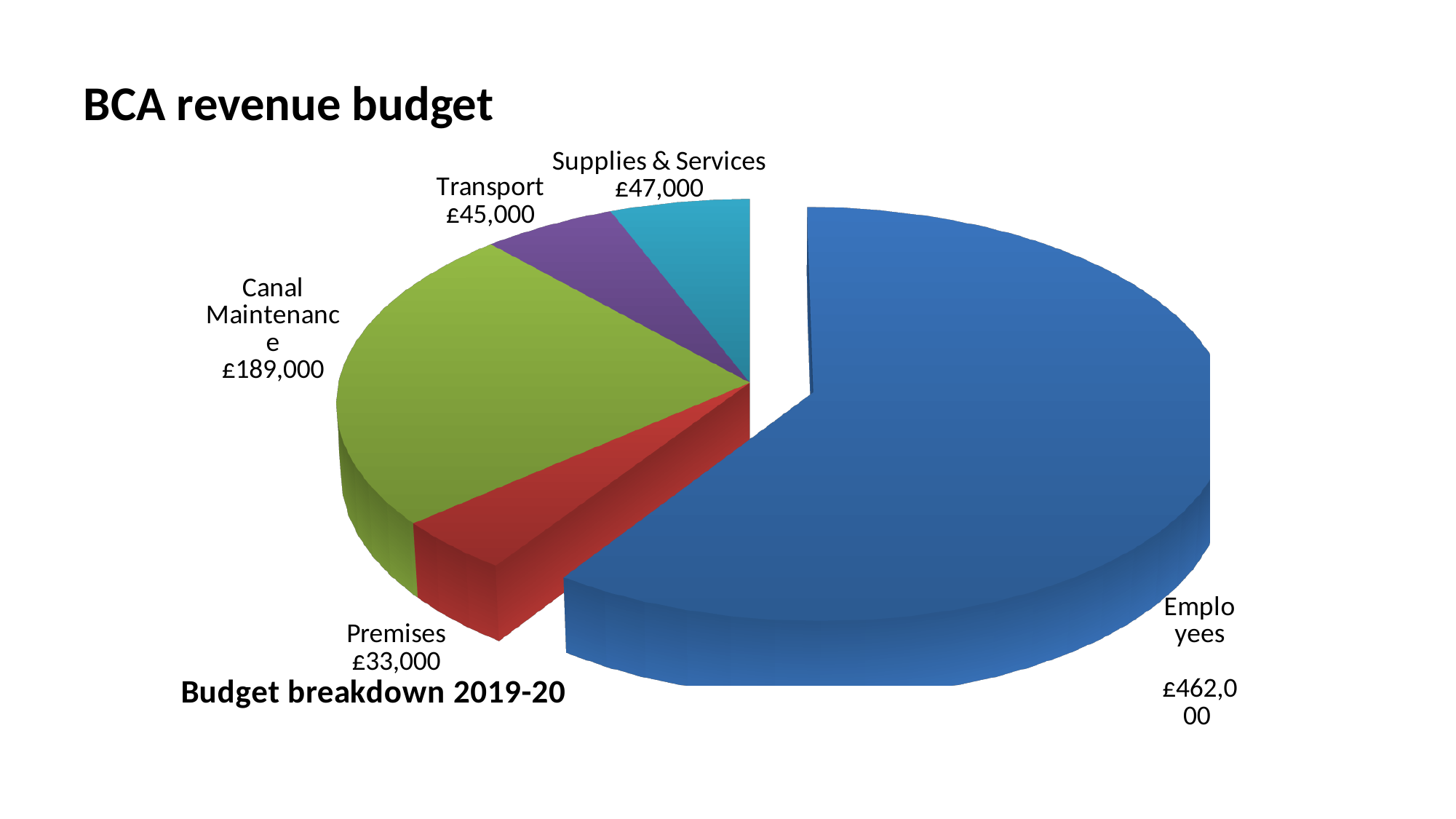
What is the budget value for Premises? £33,000 Which category has the largest budget? Employees What kind of chart is shown on the slide? Pie chart Which is larger, the budget for Supplies & Services or the budget for Transport? Supplies & Services What is the budget value for Employees? £462,000 Which category has the smallest budget? Premises How many categories are shown in the pie chart? 5 What is the total of all the budget categories shown in the pie chart? £776,000 What is the budget value for Transport? £45,000 What is the difference between the Employees budget and the Canal Maintenance budget? £273,000 What is the title of the pie chart? Budget breakdown 2019-20 What is the budget value for Canal Maintenance? £189,000